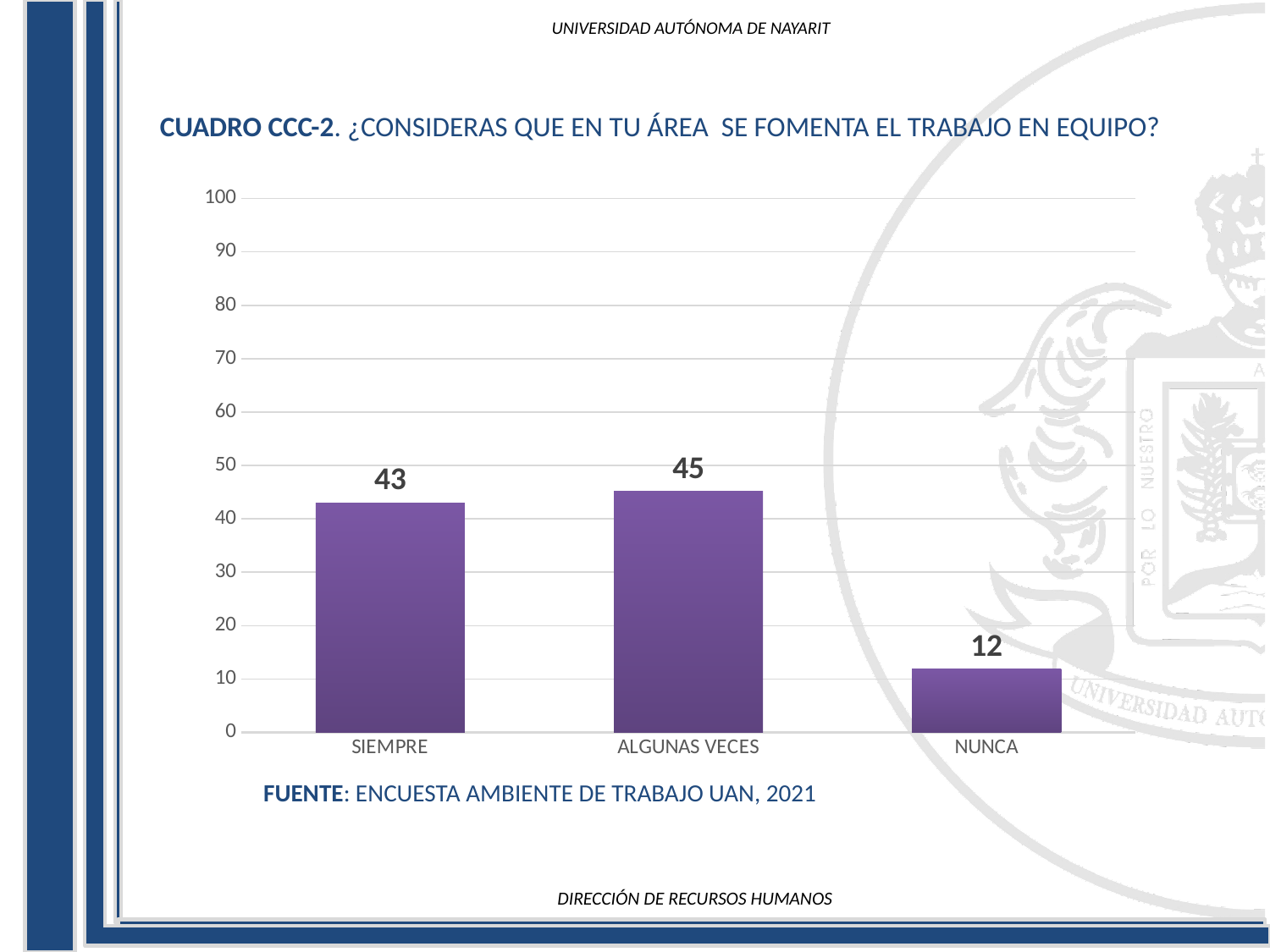
What is the difference between the values for SIEMPRE and NUNCA? 31 What is the value for NUNCA? 12 Which is larger, the value for SIEMPRE or the value for NUNCA? SIEMPRE How many categories are shown on the x axis? 3 Is the value for NUNCA greater or less than 20? less Which category has the highest value? ALGUNAS VECES What is the difference between the values for ALGUNAS VECES and SIEMPRE? 2 Which category has the lowest value? NUNCA What source is cited below the chart? ENCUESTA AMBIENTE DE TRABAJO UAN, 2021 What kind of chart is shown on the slide? bar chart What is the value for SIEMPRE? 43 What is the value for ALGUNAS VECES? 45